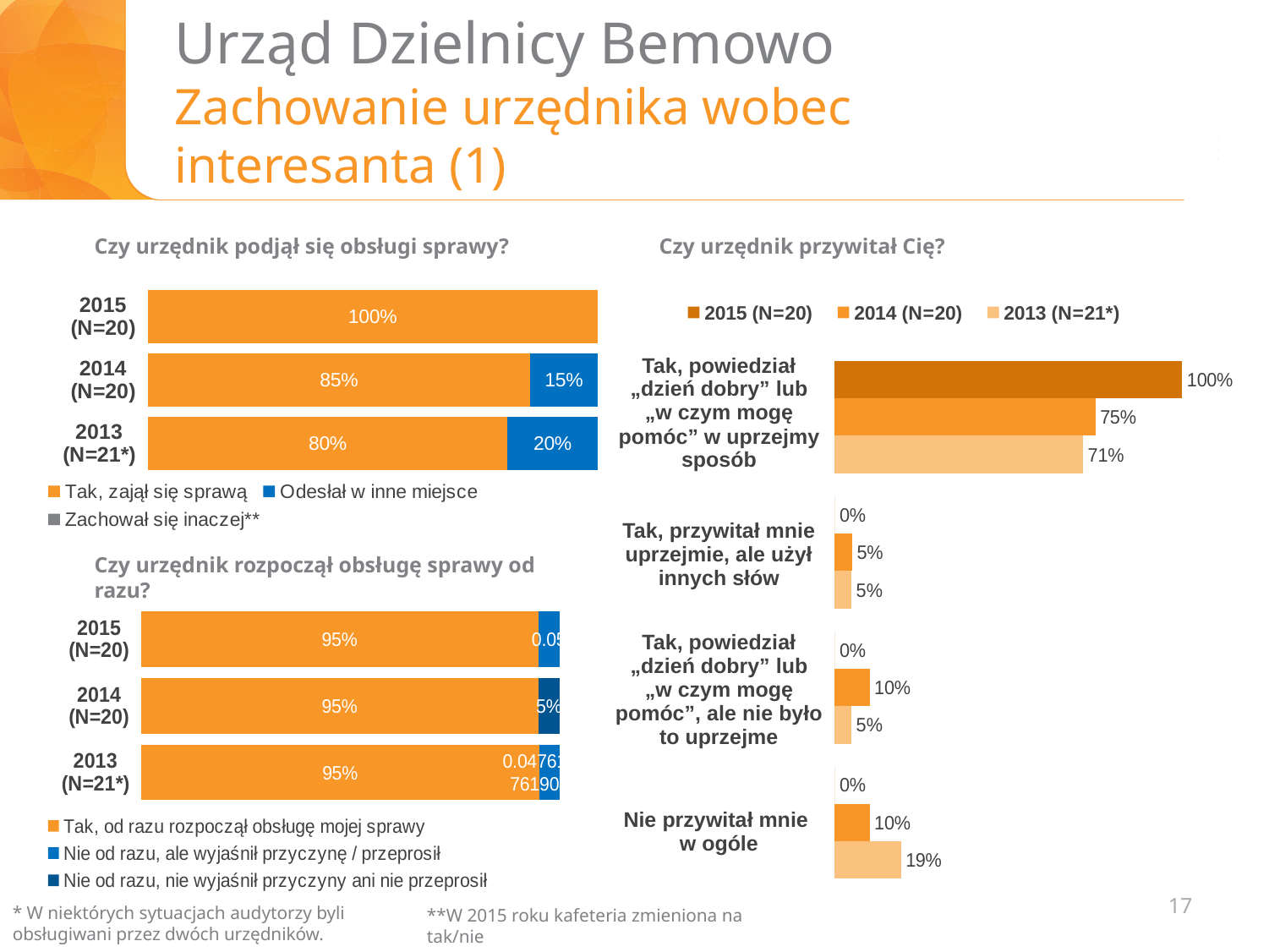
In the chart 'Czy urzędnik podjął się obsługi sprawy?', what is the value for 'Tak, zajął się sprawą' in 2015 (N=20)? 100% In the chart 'Czy urzędnik rozpoczął obsługę sprawy od razu?', what is the value for 'Tak, od razu rozpoczął obsługę mojej sprawy' in 2014 (N=20)? 95% What kind of chart is 'Czy urzędnik podjął się obsługi sprawy?'? Stacked bar chart In the chart 'Czy urzędnik podjął się obsługi sprawy?', what is the difference between the 'Tak, zajął się sprawą' values for 2014 (N=20) and 2013 (N=21*)? 5% In the chart 'Czy urzędnik podjął się obsługi sprawy?', how many series does the legend list? 3 In the chart 'Czy urzędnik rozpoczął obsługę sprawy od razu?', how many year categories are shown? 3 In the chart 'Czy urzędnik przywitał Cię?', how many response categories are shown on the vertical axis? 4 In the chart 'Czy urzędnik przywitał Cię?', what is the 2013 (N=21*) value for 'Nie przywitał mnie w ogóle'? 19% In the chart 'Czy urzędnik podjął się obsługi sprawy?', what is the value for 'Odesłał w inne miejsce' in 2013 (N=21*)? 20% In the chart 'Czy urzędnik przywitał Cię?', what is the 2014 (N=20) value for 'Tak, powiedział „dzień dobry” lub „w czym mogę pomóc” w uprzejmy sposób'? 75% In the chart 'Czy urzędnik przywitał Cię?', which year has the highest value for 'Tak, powiedział „dzień dobry” lub „w czym mogę pomóc” w uprzejmy sposób'? 2015 (N=20) In the chart 'Czy urzędnik przywitał Cię?', what is the difference between the 2015 (N=20) and 2013 (N=21*) values for 'Tak, powiedział „dzień dobry” lub „w czym mogę pomóc” w uprzejmy sposób'? 29%